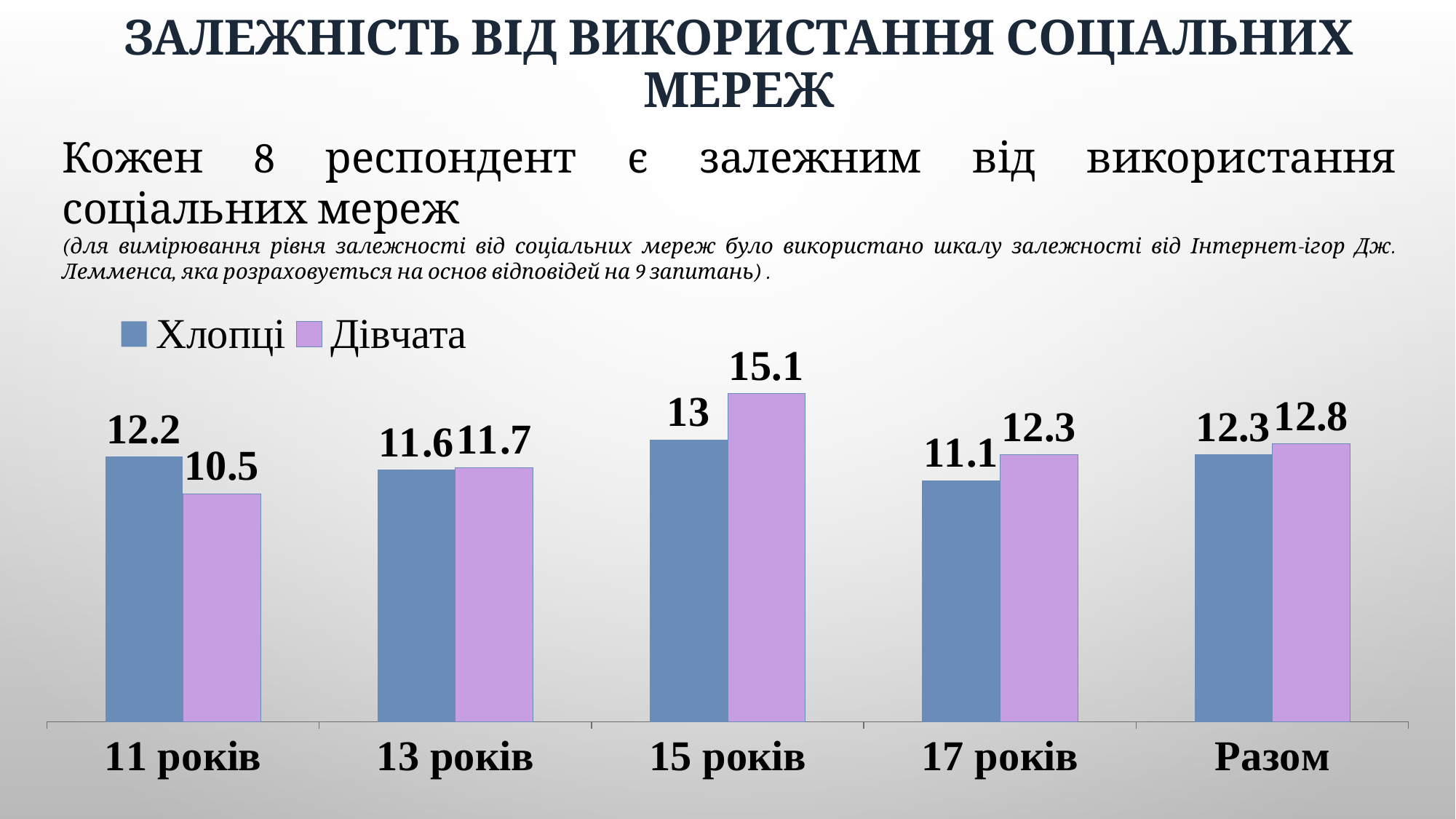
Which series is shown in purple in the legend? Дівчата How many series does the legend list? 2 Which is larger at 11 років, Хлопці or Дівчата? Хлопці What is the difference between Хлопці at 11 років and Хлопці at 17 років? 1.1 What is the difference between Дівчата and Хлопці at 15 років? 2.1 Which category has the lowest value for Хлопці? 17 років What is the value for Дівчата in the Разом category? 12.8 What is the value for Дівчата at 15 років? 15.1 Which age category has the highest value for Дівчата? 15 років What kind of chart is shown on the slide? bar chart How many categories are shown on the x axis? 5 What is the value for Хлопці at 11 років? 12.2